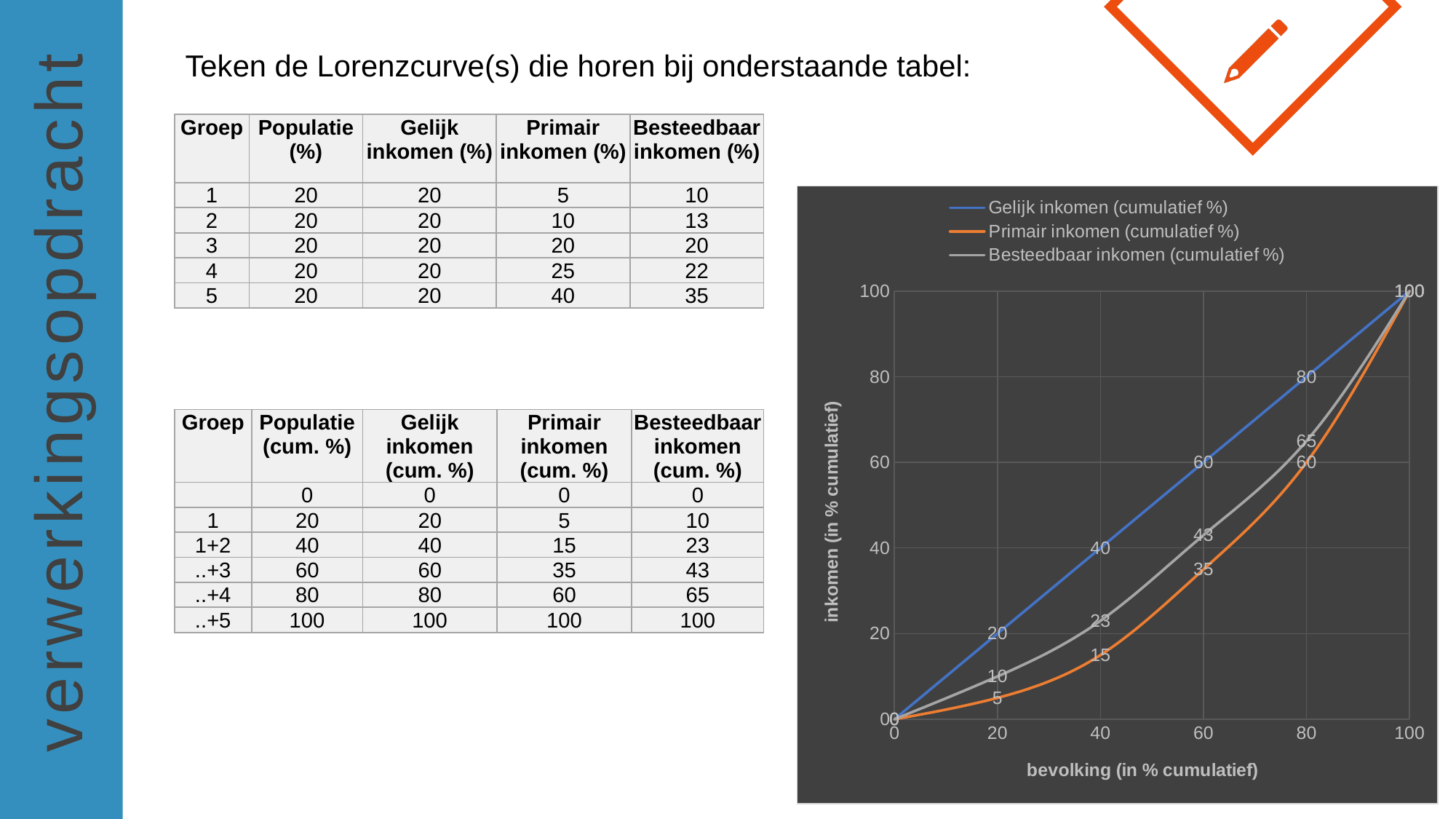
What is the cumulative Primair inkomen value at 40% of the population? 15 What is the cumulative Besteedbaar inkomen value at 80% of the population? 65 What is the cumulative Besteedbaar inkomen value at 60% of the population? 43 At 40% of the population, what is the difference between the Gelijk inkomen and Primair inkomen cumulative values? 25 At 60% of the population, which series has the lowest cumulative income value? Primair inkomen (cumulatief %) Do the values of the Primair inkomen series rise or fall as the population percentage increases? rise At 80% of the population, which is larger: the Besteedbaar inkomen value or the Primair inkomen value? Besteedbaar inkomen Which colour is used for the Gelijk inkomen (cumulatief %) line? blue What is the label of the x axis of the chart? bevolking (in % cumulatief) What kind of chart is shown on the slide? line chart What is the cumulative Primair inkomen value at 20% of the population? 5 How many series does the chart legend list? 3